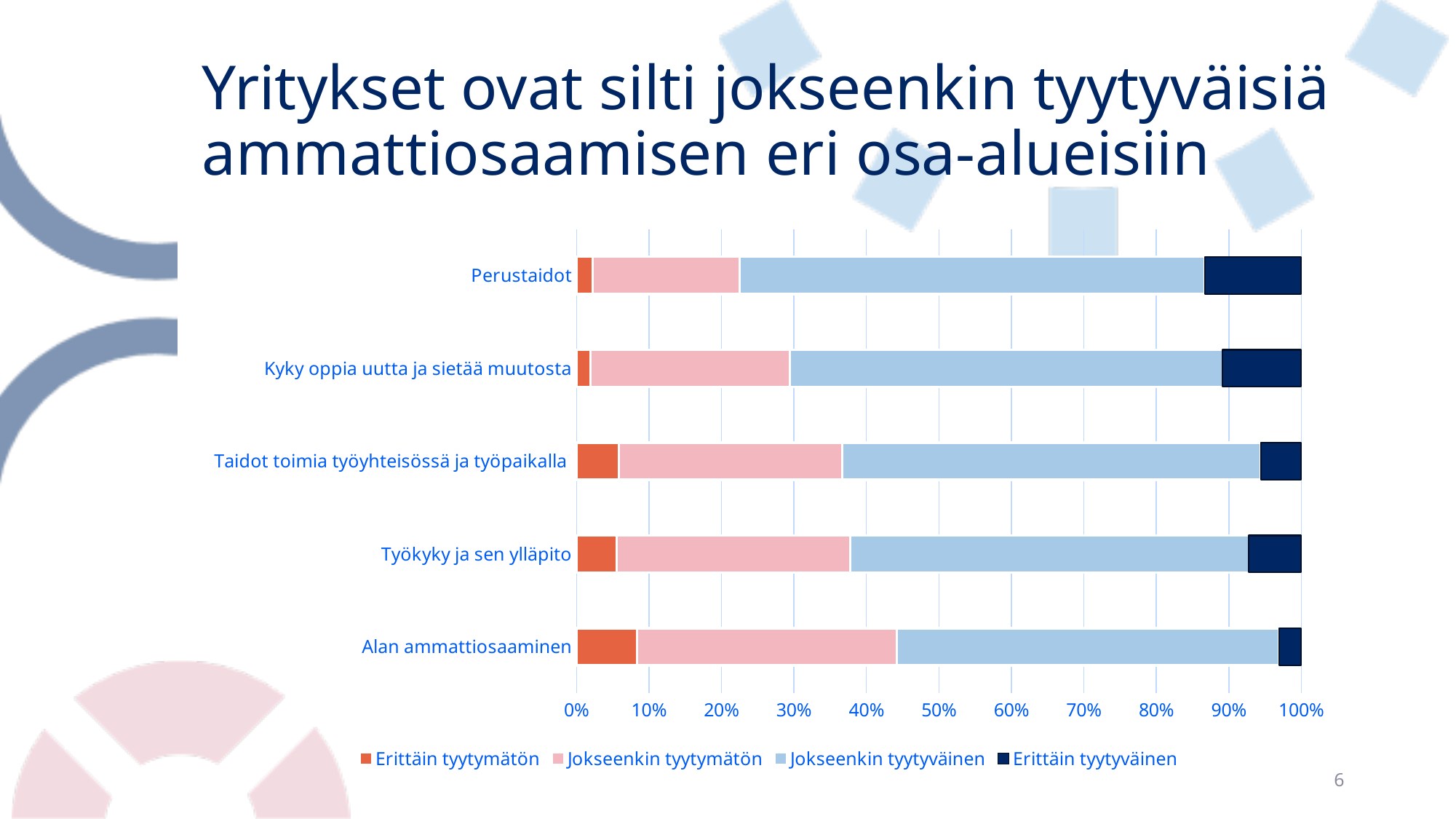
Which has a larger 'Erittäin tyytymätön' share: Perustaidot or Alan ammattiosaaminen? Alan ammattiosaaminen Which category has the largest 'Erittäin tyytyväinen' segment? Perustaidot Which category has the largest 'Erittäin tyytymätön' segment? Alan ammattiosaaminen How many series does the legend list? 4 Which legend entry is shown in the darkest blue colour? Erittäin tyytyväinen Which category has the smallest 'Jokseenkin tyytymätön' segment? Perustaidot Is the 'Erittäin tyytymätön' share for Alan ammattiosaaminen greater or less than 10%? less What does each stacked bar total on the x axis? 100% How many categories (skill areas) are plotted on the chart? 5 What kind of chart is shown on the slide? Stacked bar chart Is the 'Jokseenkin tyytymätön' share for Alan ammattiosaaminen greater or less than 30%? greater Which category has the smallest 'Erittäin tyytyväinen' segment? Alan ammattiosaaminen